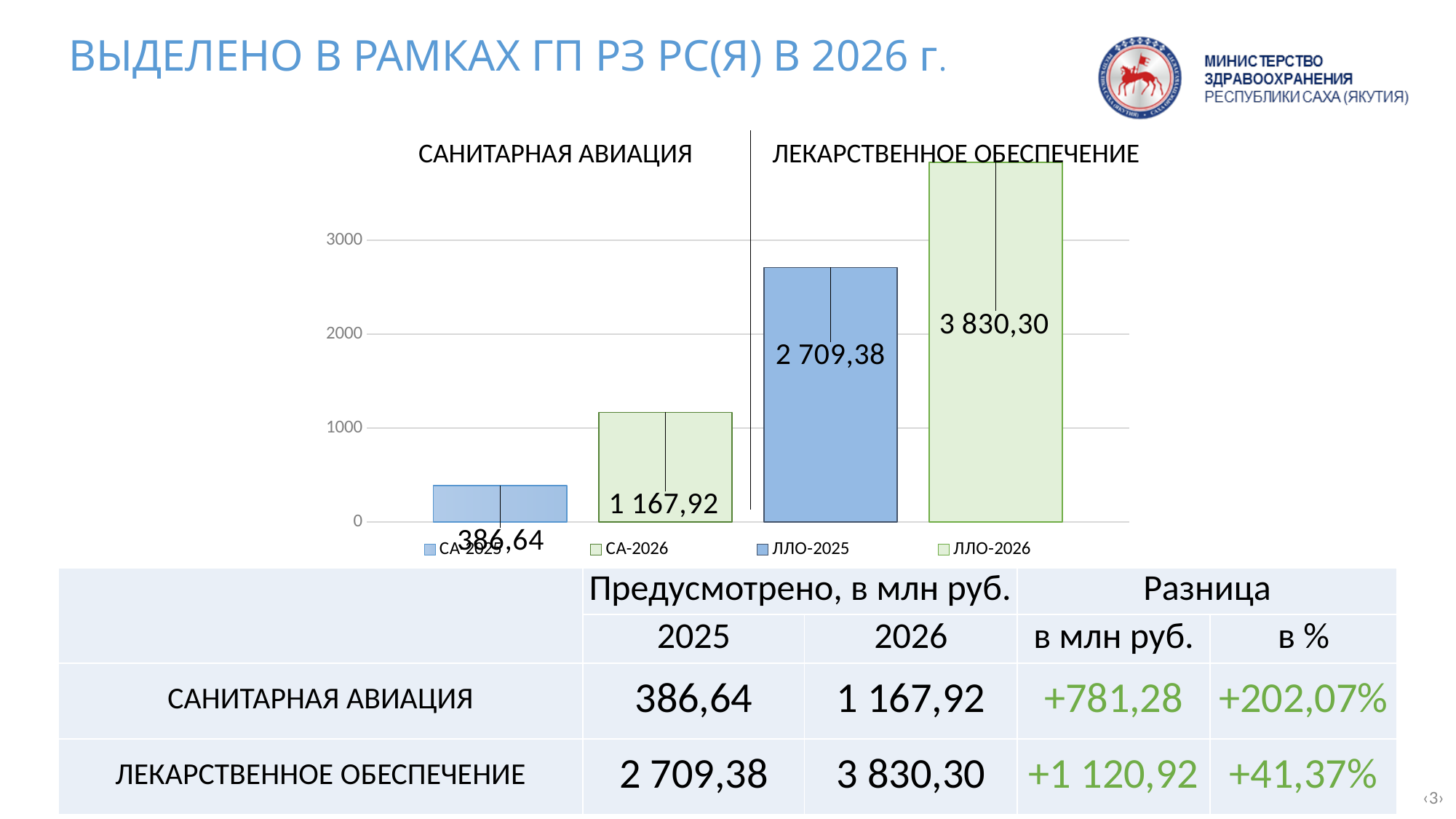
Which bar has the lowest value? СА-2025 What is the value of the СА-2025 bar? 386,64 What is the difference between the СА-2026 and СА-2025 bars? 781,28 Which is larger, the СА-2026 bar or the ЛЛО-2025 bar? ЛЛО-2025 What is the difference between the ЛЛО-2026 and ЛЛО-2025 bars? 1 120,92 What is the value of the ЛЛО-2026 bar? 3 830,30 Is the value for ЛЛО-2025 greater or less than 2000? greater What is the value of the СА-2026 bar? 1 167,92 What kind of chart is shown on the slide? bar chart What is the value of the ЛЛО-2025 bar? 2 709,38 How many series does the legend list? 4 Which bar has the highest value? ЛЛО-2026